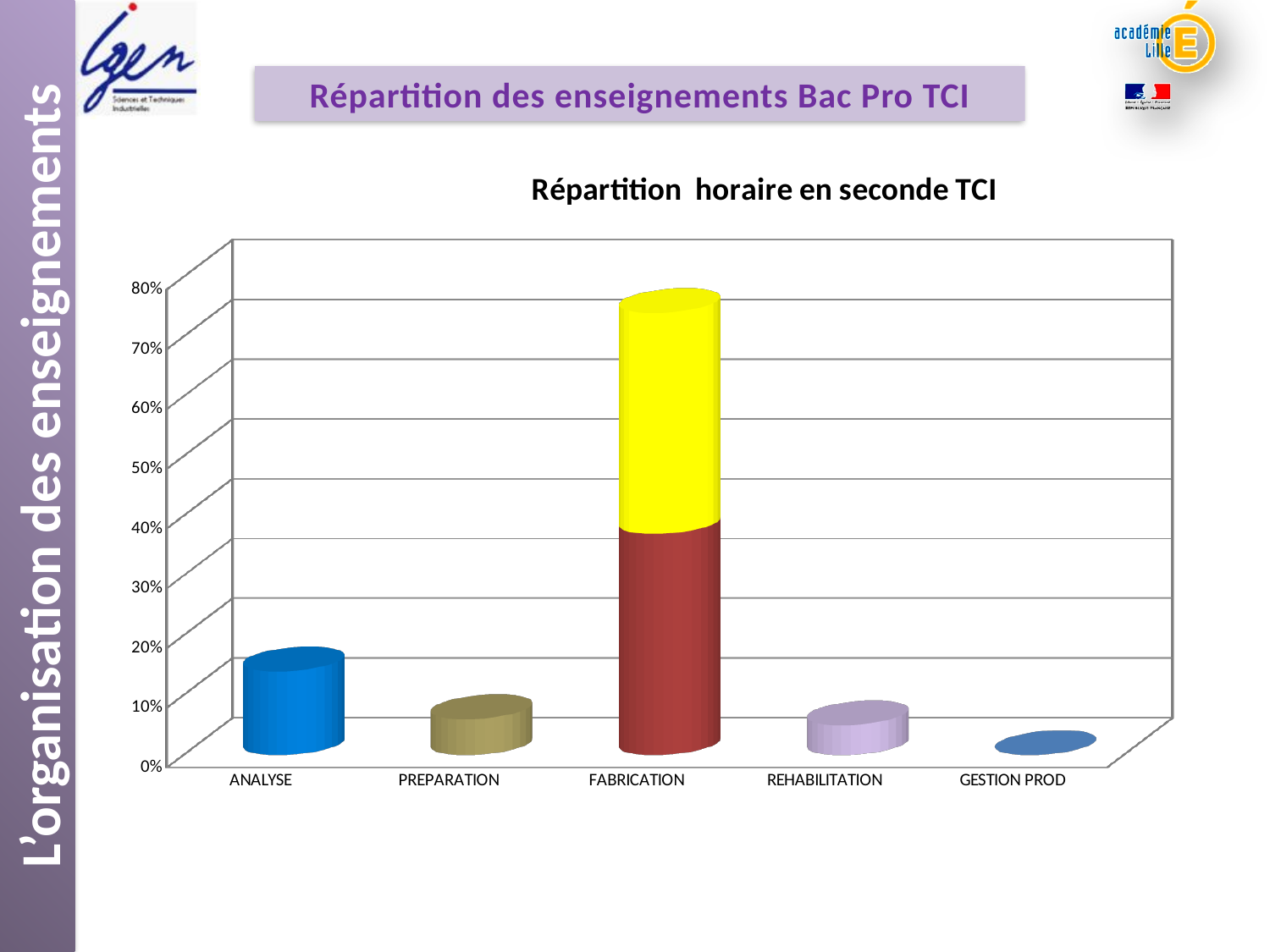
Is the value for GESTION PROD greater or less than 10%? less Is the value for FABRICATION greater or less than 60%? greater Which category has the highest value in the chart? FABRICATION Is the value for PREPARATION greater or less than 20%? less Which category has the lowest value in the chart? GESTION PROD How many categories are shown on the x axis of the chart? 5 Which is larger, the value for ANALYSE or the value for PREPARATION? ANALYSE What is the title of the chart? Répartition horaire en seconde TCI What kind of chart is shown on the slide? bar chart Which is larger, the value for FABRICATION or the value for ANALYSE? FABRICATION